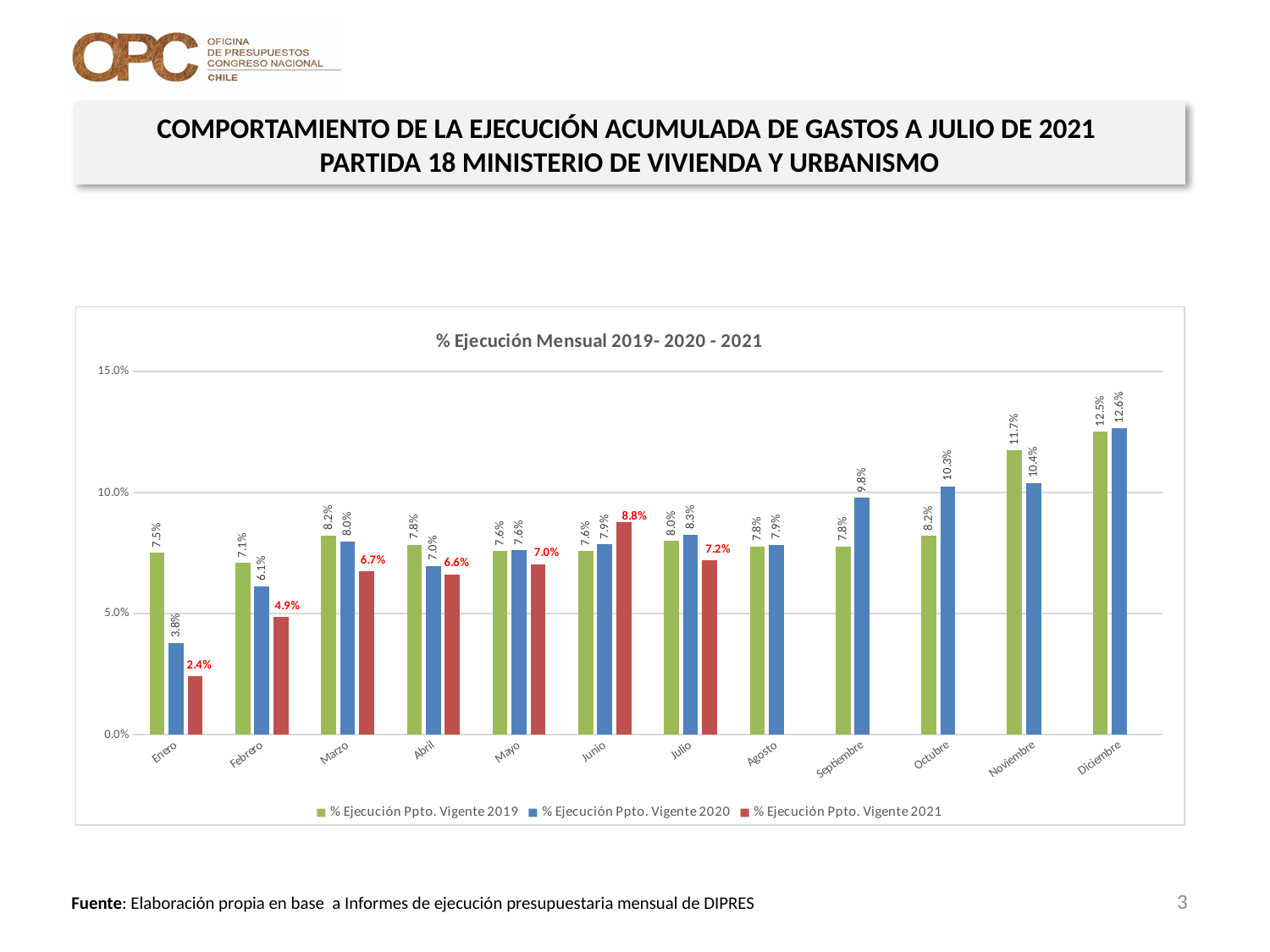
What is the value for % Ejecución Ppto. Vigente 2019 in Noviembre? 11.7% What is the value for % Ejecución Ppto. Vigente 2020 in Octubre? 10.3% What is the value for % Ejecución Ppto. Vigente 2021 in Enero? 2.4% What is the difference between the 2019 and 2021 values in Enero? 5.1% What is the title of the chart? % Ejecución Mensual 2019- 2020 - 2021 How many months are shown on the x axis? 12 Which is larger in Julio: the 2020 value or the 2021 value? 2020 value (8.3%) What kind of chart is shown? Bar chart Is the value for % Ejecución Ppto. Vigente 2020 in Septiembre greater or less than 10.0%? less In which month is the % Ejecución Ppto. Vigente 2021 series highest? Junio In which month is the % Ejecución Ppto. Vigente 2020 series lowest? Enero How many series does the legend list? 3